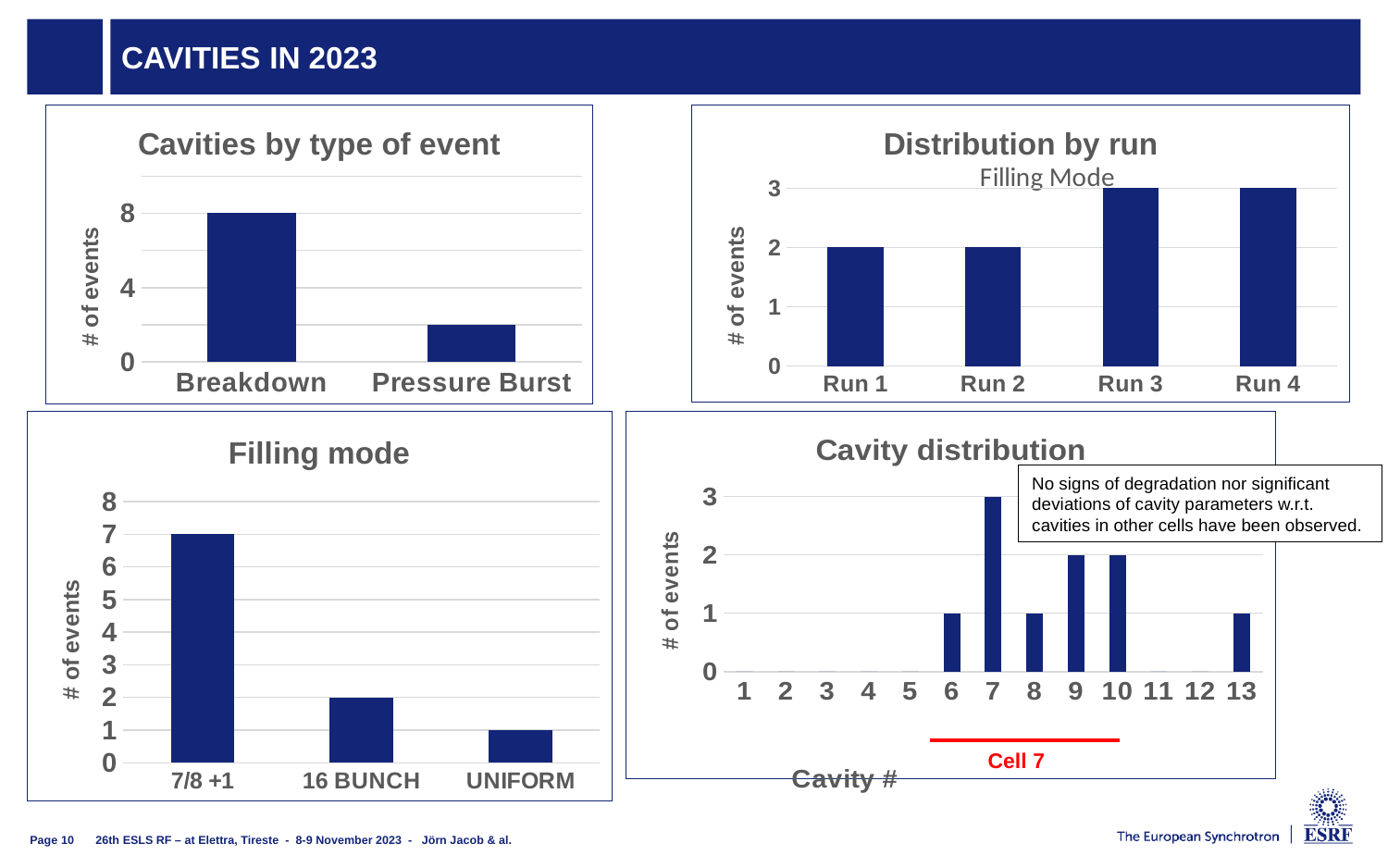
In the 'Distribution by run' chart, how many events are shown for Run 1? 2 In the 'Cavity distribution' chart, which cavity number has the highest number of events? 7 In the 'Filling mode' chart, what is the difference between the values for 7/8 +1 and 16 BUNCH? 5 What type of chart is the 'Distribution by run' chart? bar chart How many cavity numbers are listed on the x axis of the 'Cavity distribution' chart? 13 In the 'Cavities by type of event' chart, is the value for Pressure Burst greater or less than 4? less In the 'Filling mode' chart, which category has the lowest number of events? UNIFORM In the 'Distribution by run' chart, how many events are shown for Run 3? 3 In the 'Distribution by run' chart, what is the difference between the values for Run 4 and Run 2? 1 In the 'Cavities by type of event' chart, how many events are shown for Breakdown? 8 In the 'Filling mode' chart, how many events are shown for 7/8 +1? 7 In the 'Cavity distribution' chart, how many events are shown for cavity 9? 2